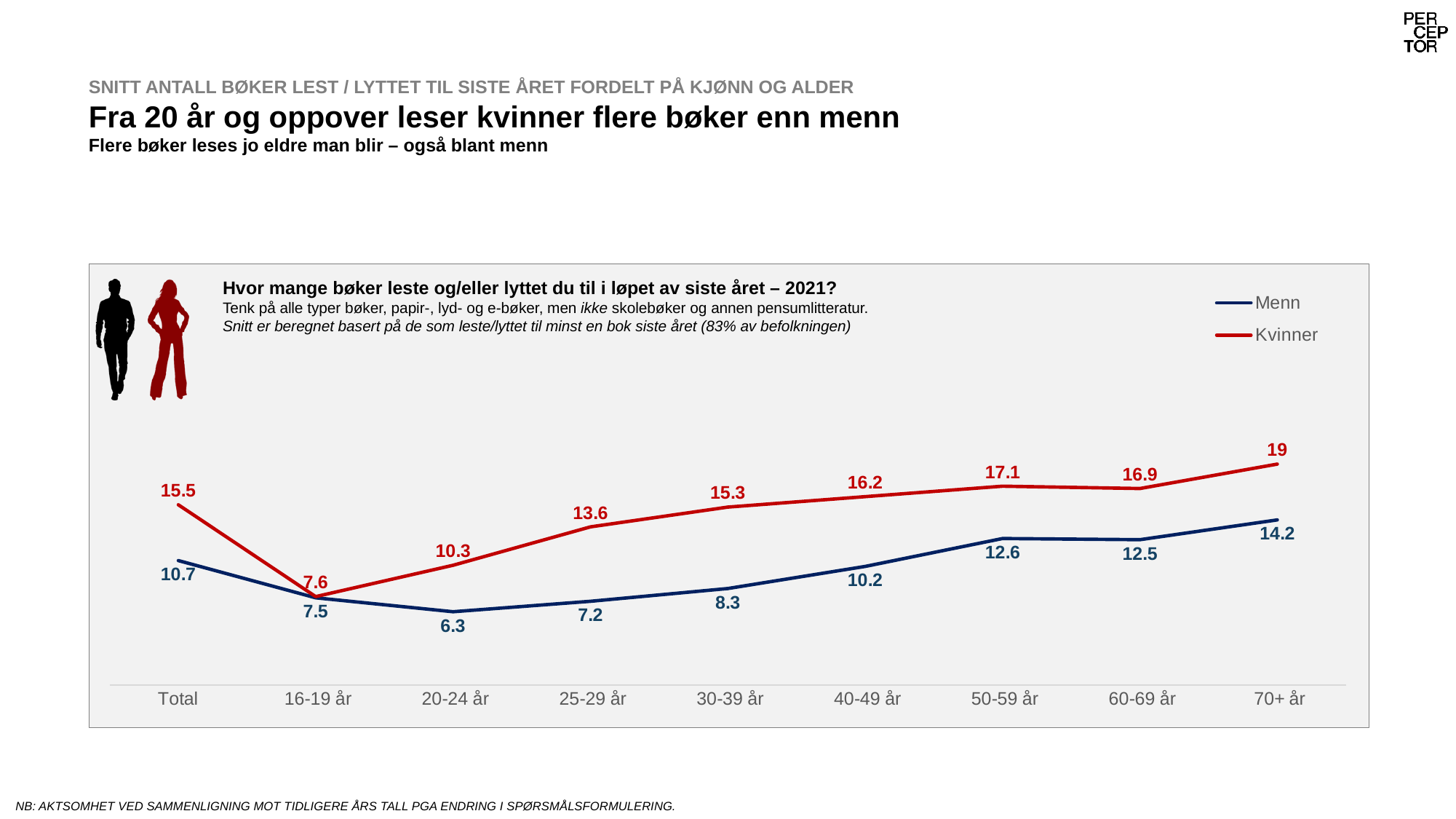
Which age category has the highest value for Menn? 70+ år How many categories are shown on the x axis? 9 What is the value for Kvinner in the Total category? 15.5 How many series does the legend list? 2 What colour is the line for Kvinner? Red What is the value for Menn in the 20-24 år category? 6.3 Which category has the lowest value for Kvinner? 16-19 år What kind of chart is shown on the slide? Line chart What is the value for Kvinner in the 70+ år category? 19 What is the difference between Kvinner and Menn in the 40-49 år category? 6 Which is larger in the 16-19 år category, Menn or Kvinner? Kvinner Do the values for Menn rise or fall from 20-24 år to 70+ år? Rise